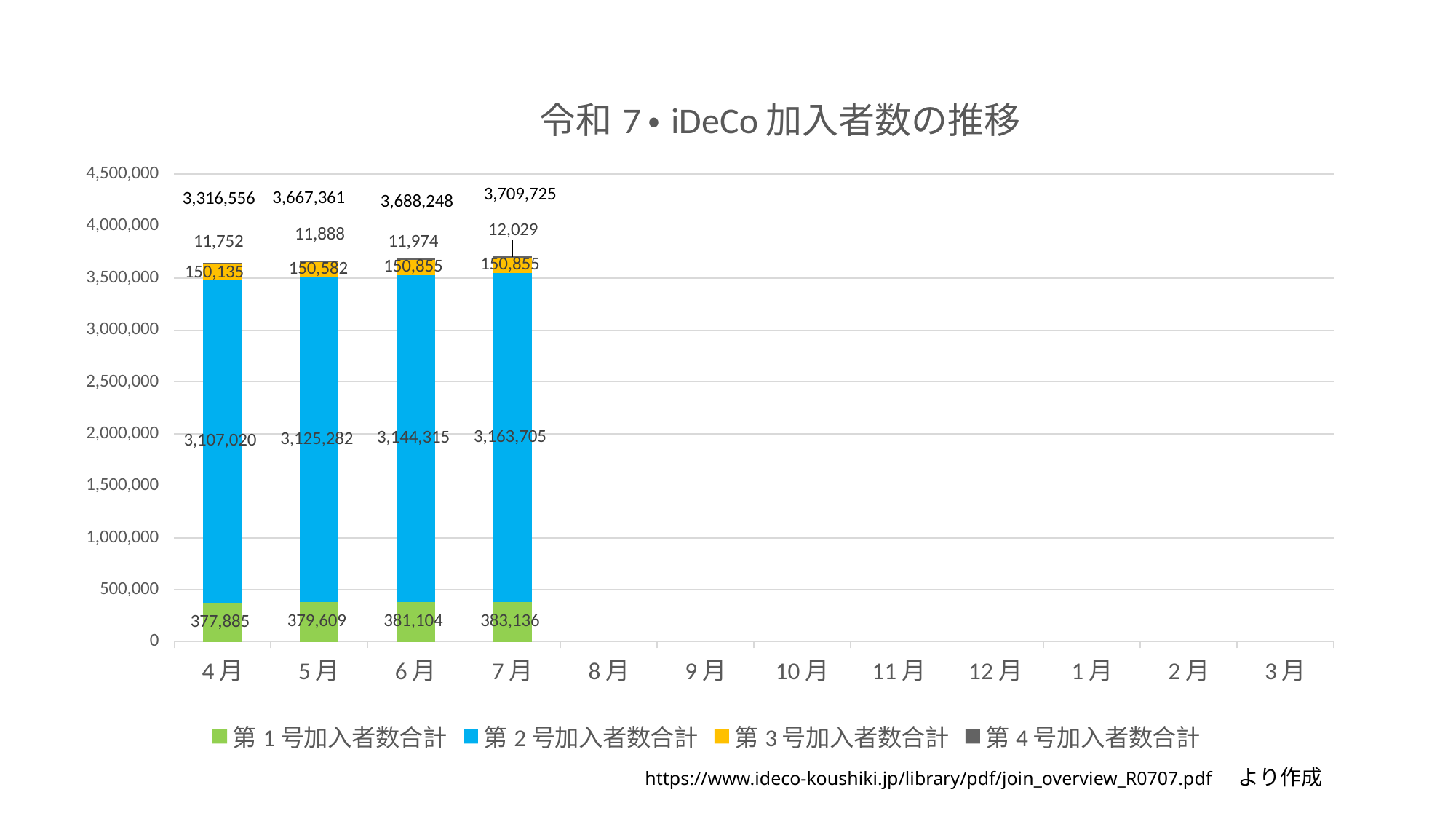
What kind of chart is shown on the slide? Stacked bar chart By how much did 第１号加入者数合計 increase from 4月 to 7月? 5,251 What is the value of 第４号加入者数合計 for 6月? 11,974 Does 第２号加入者数合計 rise or fall from 4月 to 7月? Rises Which month has the larger value for 第４号加入者数合計, 5月 or 7月? 7月 What is the difference in 第２号加入者数合計 between 6月 and 5月? 19,033 What is the value of 第３号加入者数合計 for 5月? 150,582 How many series does the legend list? 4 What is the value of 第１号加入者数合計 for 4月? 377,885 What is the value of 第２号加入者数合計 for 7月? 3,163,705 What is the total of the stacked bar for 7月? 3,709,725 How many months have bars plotted in the chart? 4